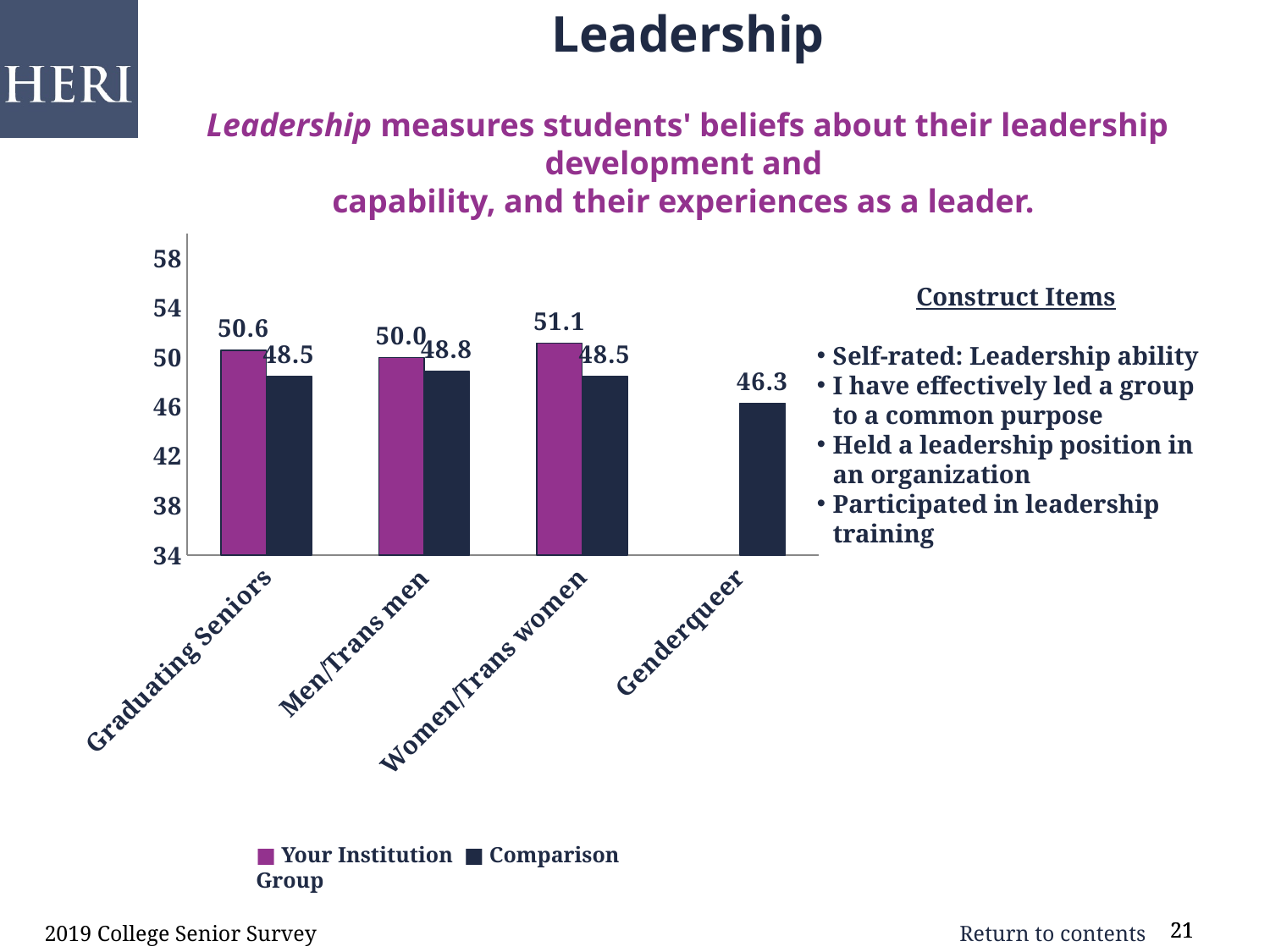
How many series does the chart legend list? 2 For Men/Trans men, which is larger: the Your Institution value or the Comparison Group value? Your Institution What is the Your Institution value for Women/Trans women? 51.1 What is the Comparison Group value for Men/Trans men? 48.8 What is the difference between the Your Institution and Comparison Group values for Women/Trans women? 2.6 Which category has the lowest Comparison Group value? Genderqueer What is the Your Institution value for Graduating Seniors? 50.6 What kind of chart is shown on the slide? Bar chart How many categories are shown on the x axis of the chart? 4 What is the Comparison Group value for Genderqueer? 46.3 What is the difference between the Your Institution and Comparison Group values for Graduating Seniors? 2.1 Which category has the highest Your Institution value? Women/Trans women